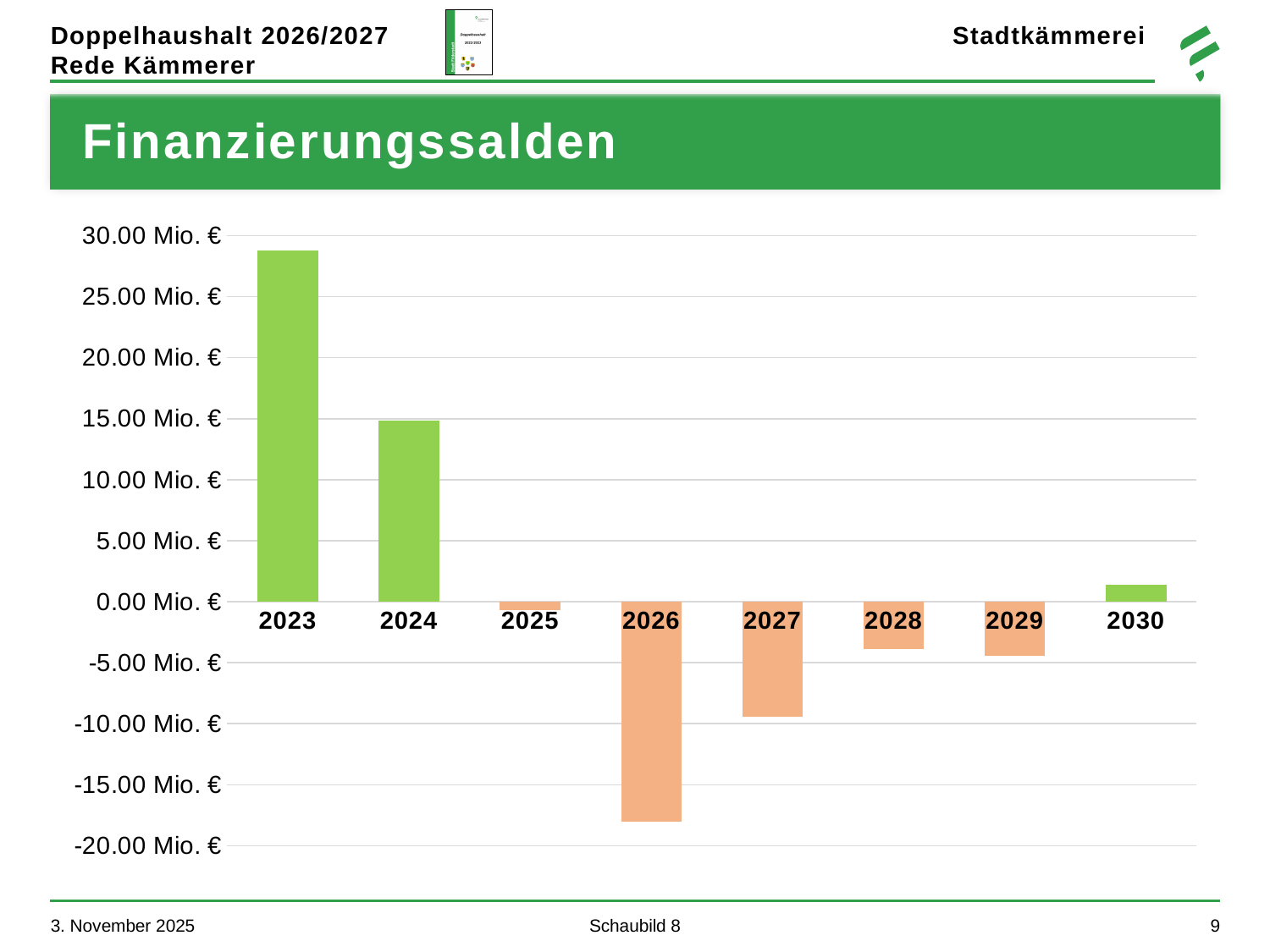
Which year has the highest Finanzierungssaldo? 2023 Is the value for 2024 greater or less than 10.00 Mio. €? greater Do the values rise or fall from 2023 to 2026? fall Is the value for 2026 greater or less than -15.00 Mio. €? less Is the value for 2023 greater or less than 25.00 Mio. €? greater Which year has the larger value, 2023 or 2024? 2023 Which year has the lowest Finanzierungssaldo? 2026 What kind of chart is shown on the slide? bar chart How many years are shown on the x axis of the chart? 8 What is the title of the chart? Finanzierungssalden How many years show a negative (orange) bar? 5